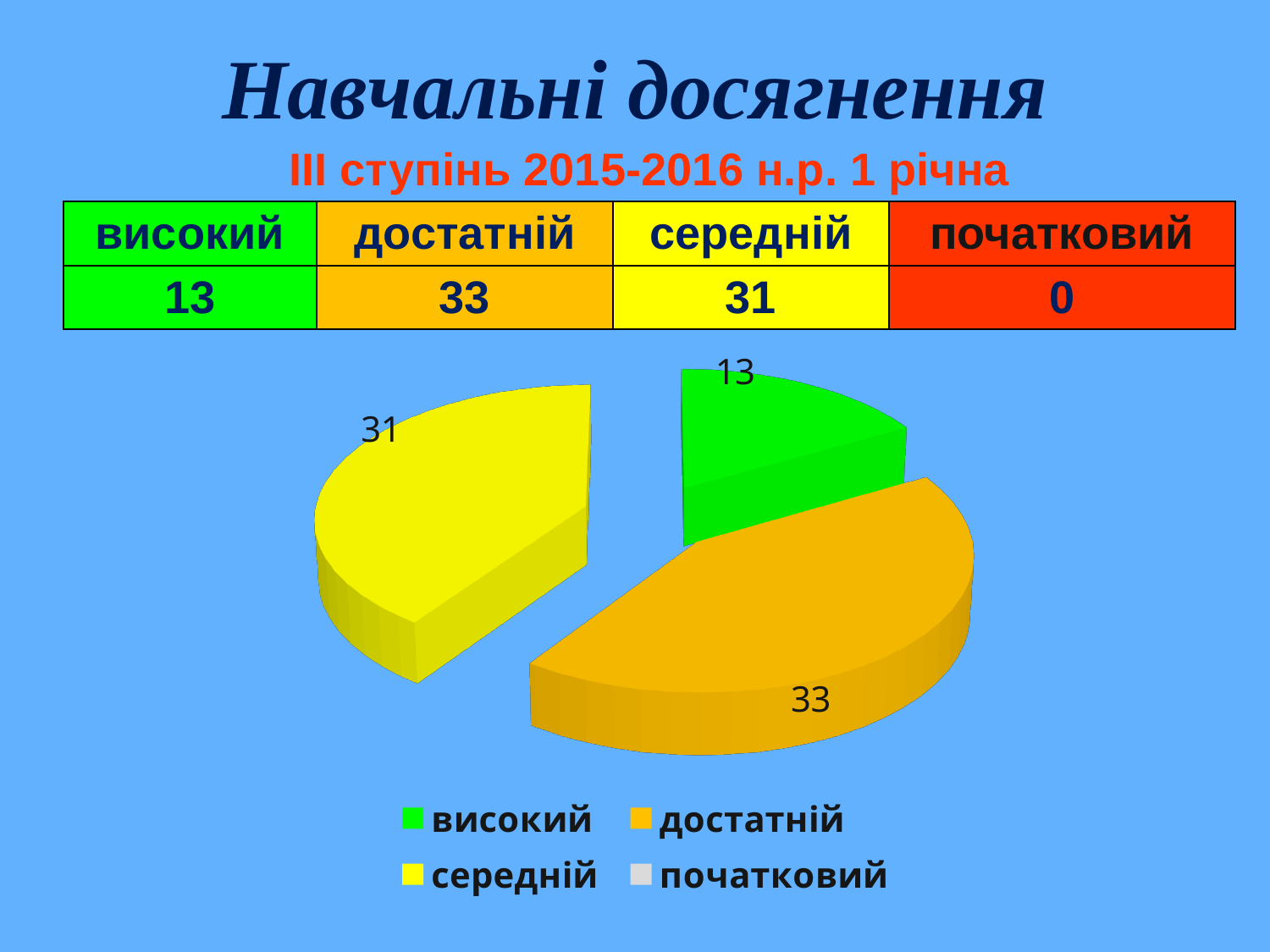
What is the value of the середній slice in the pie chart? 31 What is the value of the високий slice in the pie chart? 13 What is the value of the достатній slice in the pie chart? 33 What colour is the достатній slice in the pie chart? orange How many entries does the legend of the pie chart list? 4 What type of chart is shown on the slide? pie chart What is the value for початковий according to the table above the chart? 0 Which category has the smallest labelled slice in the pie chart? високий Which is larger, the середній slice or the високий slice? середній Which category has the largest slice in the pie chart? достатній What is the difference between the достатній and високий values? 20 What is the total of all values shown in the table above the chart? 77